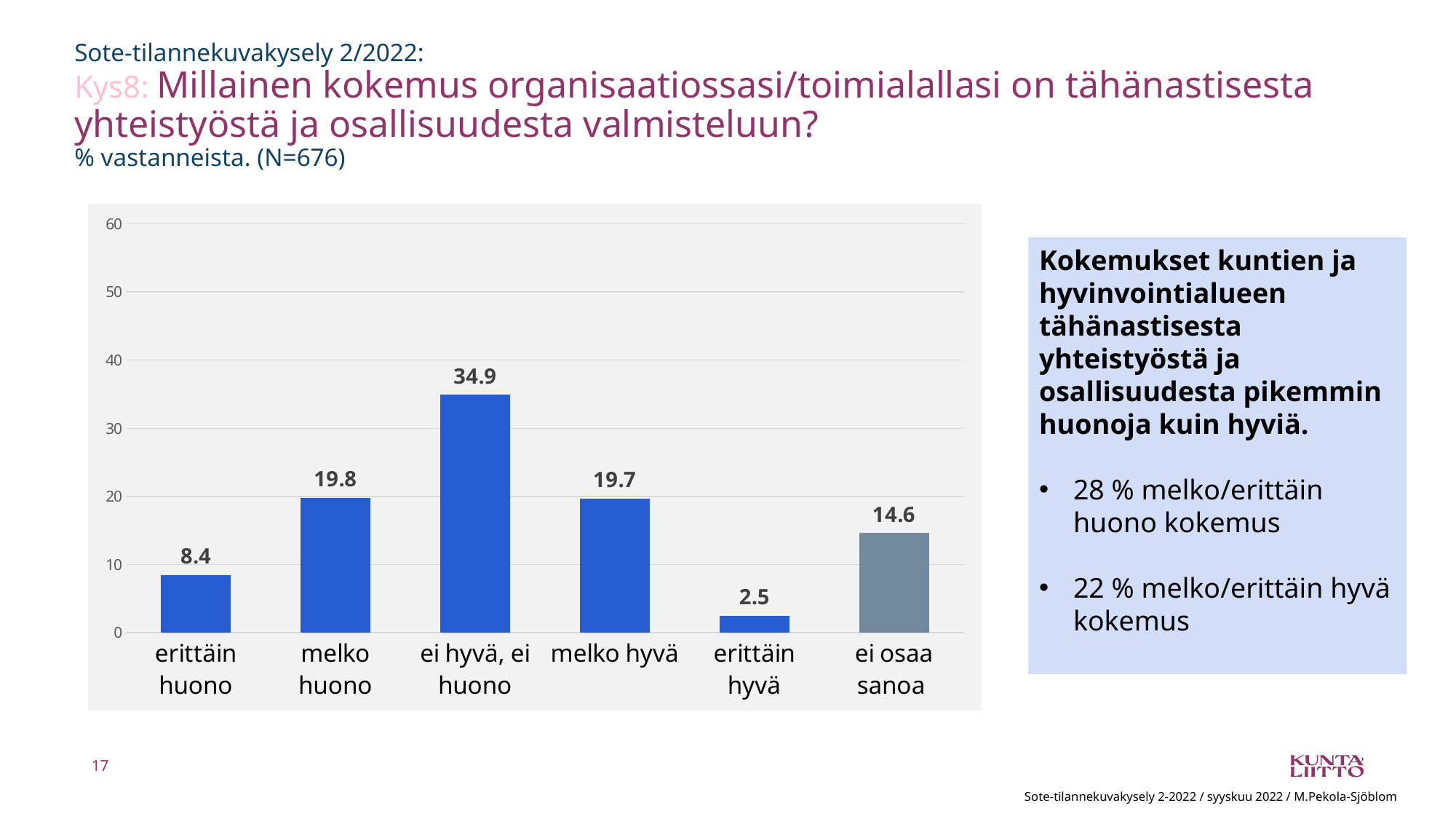
What is the value for "ei hyvä, ei huono"? 34.9 What is the value for "ei osaa sanoa"? 14.6 Which category has the lowest value? erittäin hyvä What is the difference between the values for "ei hyvä, ei huono" and "melko huono"? 15.1 Which is larger, the value for "erittäin huono" or the value for "ei osaa sanoa"? ei osaa sanoa How many categories are shown on the x axis? 6 Is the value for "ei hyvä, ei huono" greater or less than 30? greater What is the difference between the values for "ei osaa sanoa" and "erittäin huono"? 6.2 What is the sample size (N) stated in the chart subtitle? N=676 What kind of chart is shown on the slide? bar chart What is the value for "erittäin huono"? 8.4 Which category has the highest value? ei hyvä, ei huono